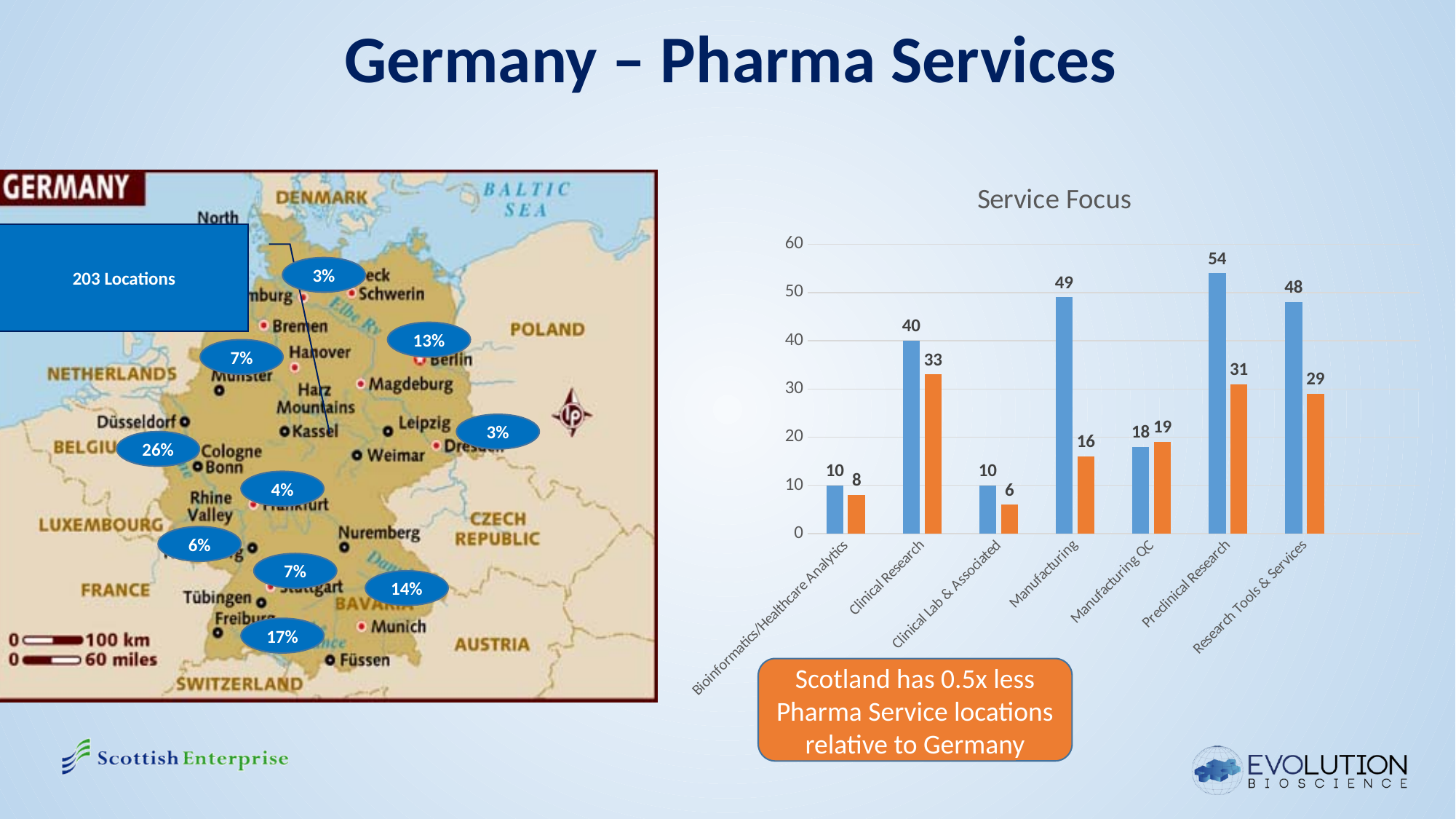
In the Service Focus chart, which category has the highest blue bar? Preclinical Research What is the title of the chart on the right side of the slide? Service Focus In the Service Focus chart, what is the difference between the blue bars for Preclinical Research and Research Tools & Services? 6 In the Service Focus chart, which category has the lowest orange bar? Clinical Lab & Associated What kind of chart is the Service Focus chart? bar chart In the Service Focus chart, is the blue bar for Clinical Research greater or less than 30? greater In the Service Focus chart, what is the value of the orange bar for Manufacturing? 16 How many categories are shown on the x axis of the Service Focus chart? 7 In the Service Focus chart, which is larger for Manufacturing QC, the blue bar or the orange bar? the orange bar In the Service Focus chart, what is the difference between the blue and orange bars for Manufacturing? 33 In the Service Focus chart, what is the value of the blue bar for Preclinical Research? 54 In the Service Focus chart, what is the value of the orange bar for Clinical Research? 33